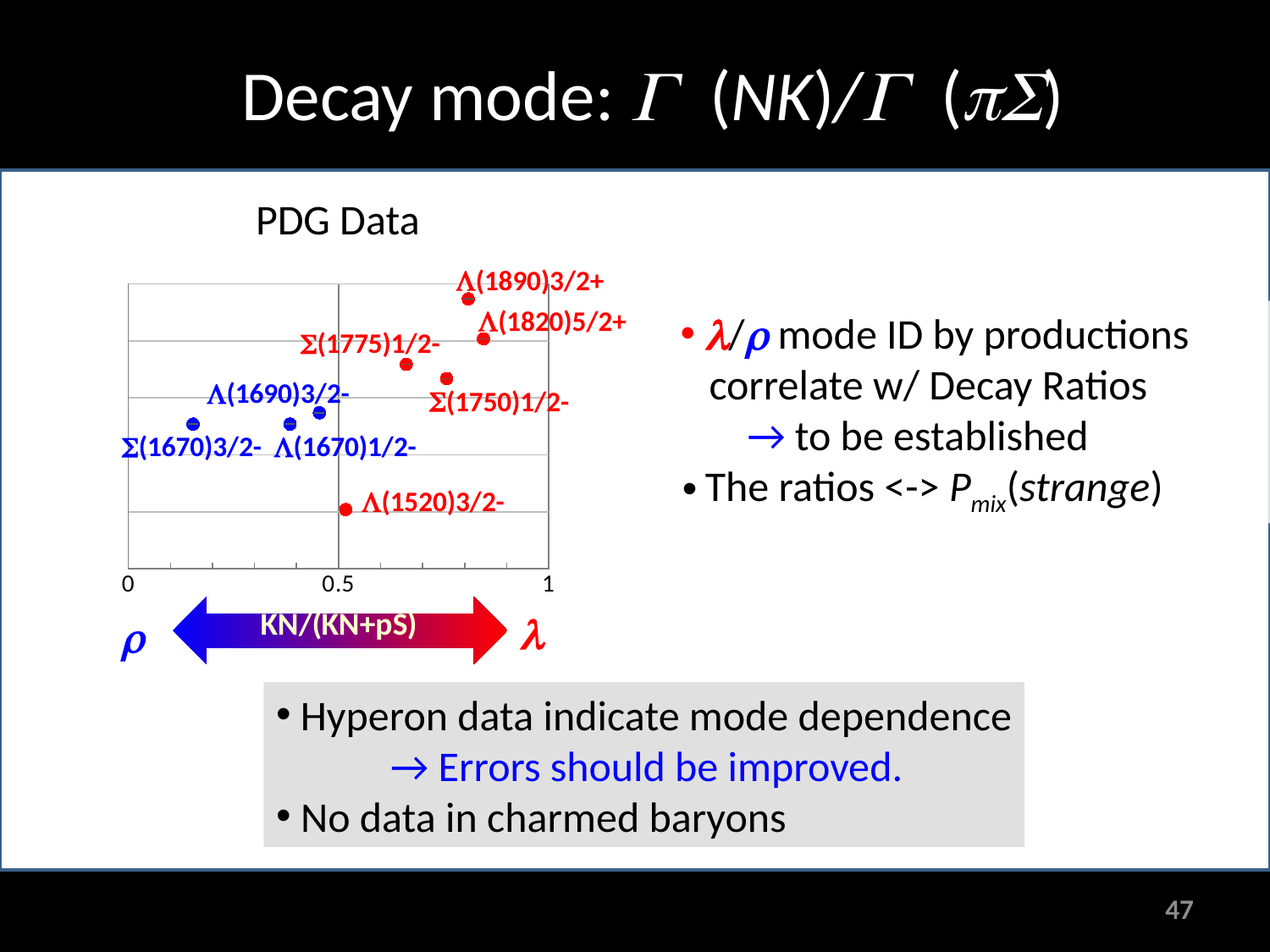
What quantity is labelled on the horizontal axis arrow below the chart? KN/(KN+pS) Is the horizontal-axis value for Λ(1890)3/2+ greater or less than 0.5? greater What kind of chart is shown on the slide? scatter chart What is the title shown above the chart? PDG Data Which has the larger horizontal-axis value, Σ(1670)3/2- or Λ(1890)3/2+? Λ(1890)3/2+ Which point is plotted highest on the vertical axis? Λ(1890)3/2+ Which point is plotted lowest on the vertical axis? Λ(1520)3/2- Which point lies furthest to the left on the horizontal axis? Σ(1670)3/2- Is the horizontal-axis value for Σ(1670)3/2- greater or less than 0.5? less Is the horizontal-axis value for Λ(1820)5/2+ greater or less than 0.5? greater How many data points are plotted in the chart? 8